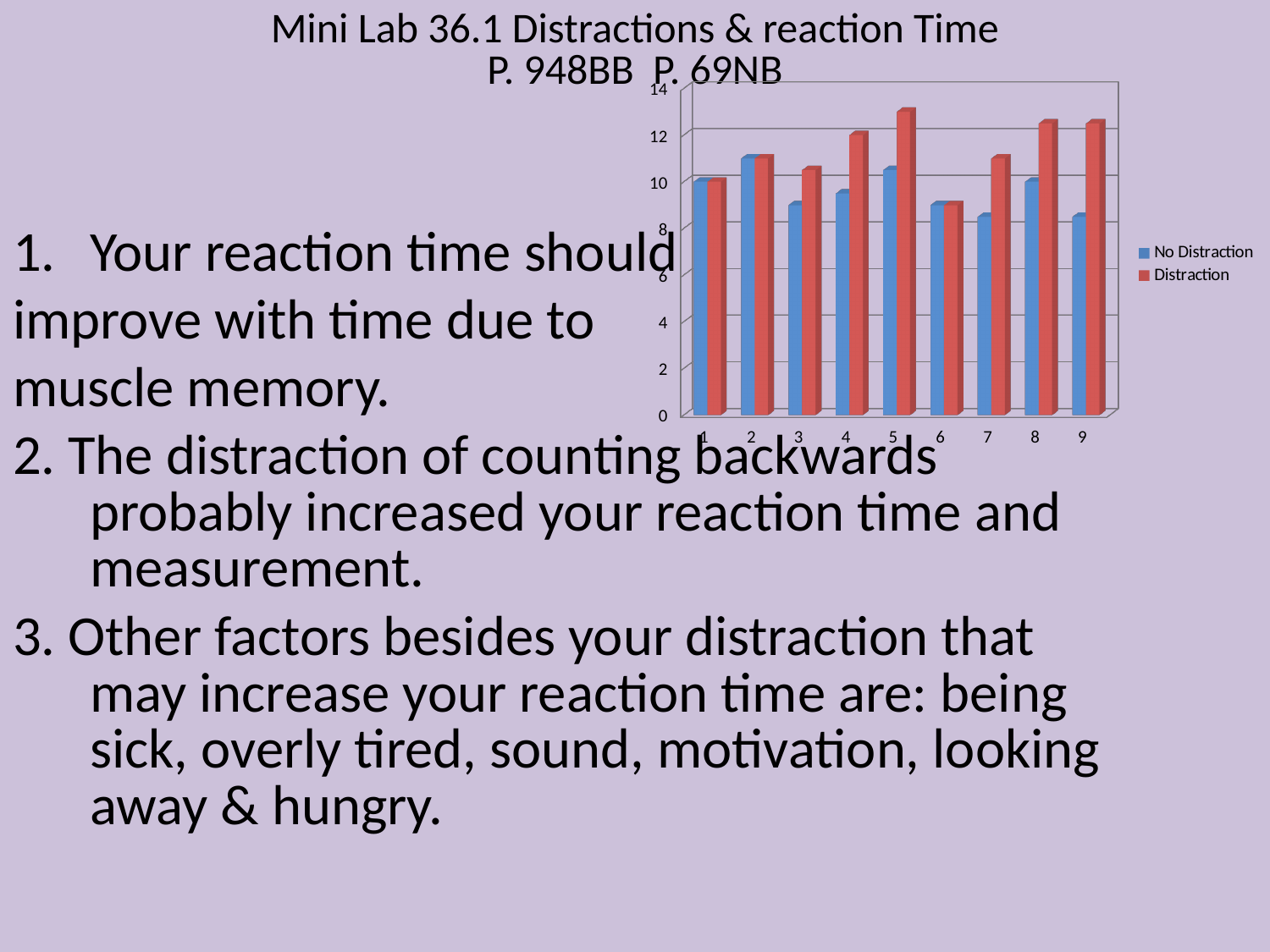
For category 4, which series has the larger value, No Distraction or Distraction? Distraction Which colour represents the Distraction series in the chart? Red For which category is the Distraction value lowest? 6 How many series does the chart legend list? 2 For category 9, which series has the larger value, No Distraction or Distraction? Distraction Is the Distraction value for category 4 greater or less than 10? greater Is the Distraction value for category 5 greater or less than 12? greater What kind of chart is shown on the slide? Bar chart For which category is the Distraction value highest? 5 What are the two series named in the chart legend? No Distraction and Distraction How many categories are shown along the x axis of the chart? 9 Is the No Distraction value for category 7 greater or less than 10? less